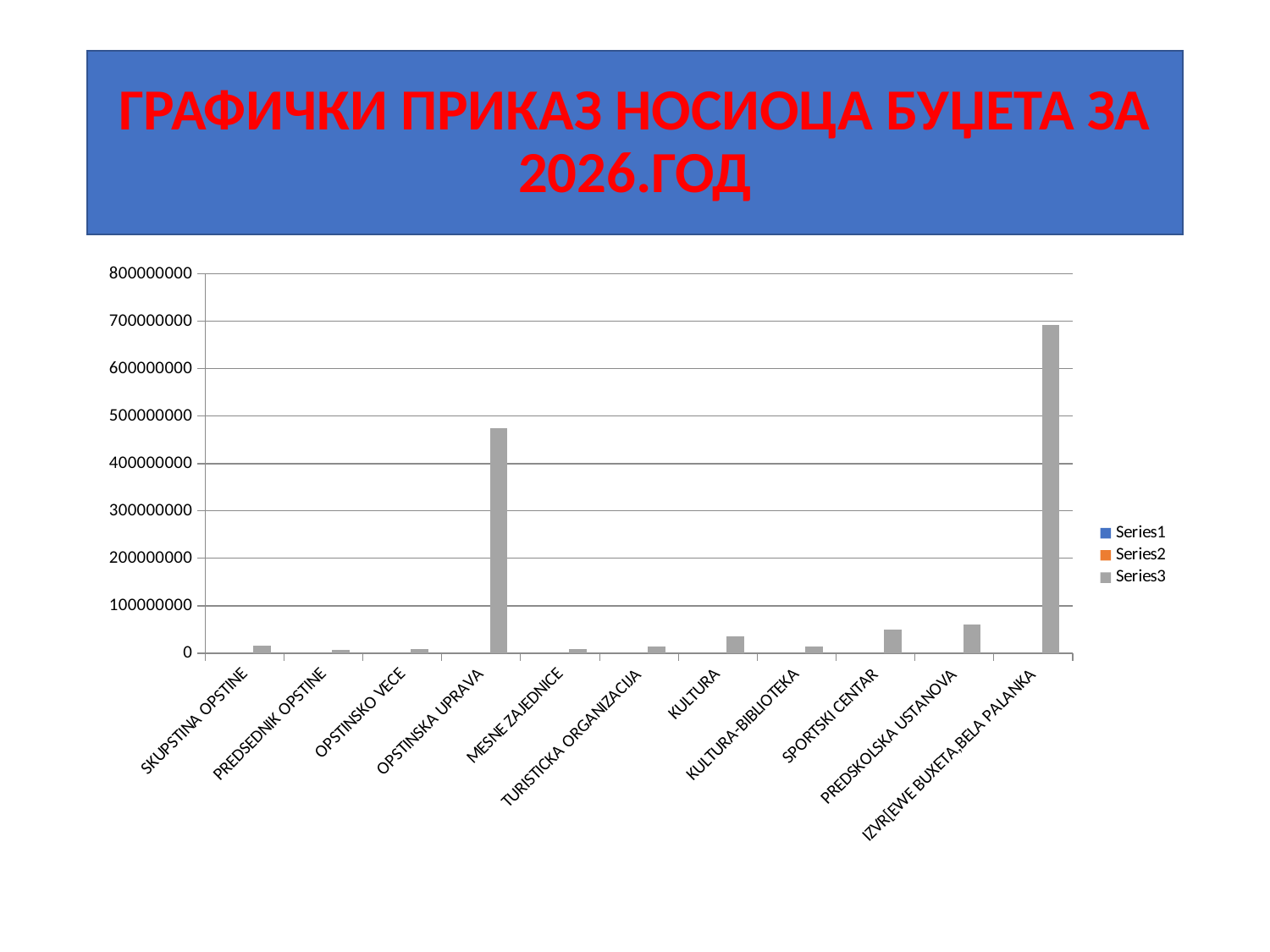
How many categories are shown on the x axis of the chart? 11 Which is larger, the value for KULTURA or the value for KULTURA-BIBLIOTEKA? KULTURA Which is larger, the value for OPSTINSKA UPRAVA or the value for KULTURA? OPSTINSKA UPRAVA Which is larger, the value for IZVR[EWE BUXETA,BELA PALANKA or the value for OPSTINSKA UPRAVA? IZVR[EWE BUXETA,BELA PALANKA Is the value for PREDSKOLSKA USTANOVA greater or less than 100000000? less What is the title shown on the slide above the chart? ГРАФИЧКИ ПРИКАЗ НОСИОЦА БУЏЕТА ЗА 2026.ГОД Is the value for IZVR[EWE BUXETA,BELA PALANKA greater or less than 600000000? greater Is the value for OPSTINSKA UPRAVA greater or less than 400000000? greater How many series does the chart's legend list? 3 Which category has the highest value in the chart? IZVR[EWE BUXETA,BELA PALANKA What kind of chart is shown on the slide? bar chart